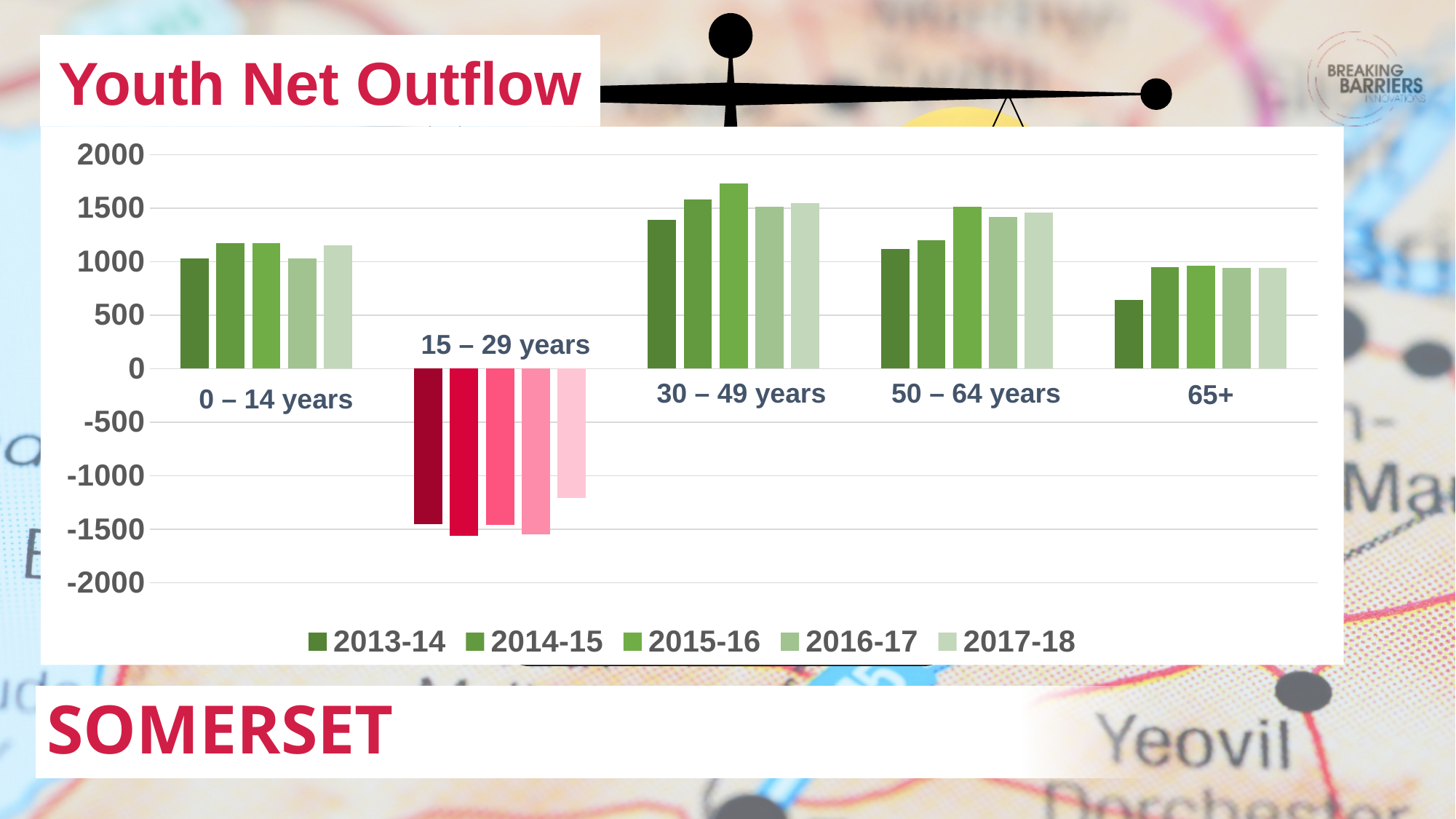
What kind of chart is shown on the slide? Bar chart Which age group has negative values for every year? 15 – 29 years Which is larger for 2013-14: the value for 30 – 49 years or the value for 50 – 64 years? 30 – 49 years Within the 30 – 49 years group, which year has the highest bar? 2015-16 Within the 65+ group, which year has the lowest bar? 2013-14 For the 30 – 49 years group, do the values rise or fall from 2013-14 to 2015-16? rise What is the title of the chart? Youth Net Outflow Is the 2017-18 value for 15 – 29 years greater or less than -1000? less How many series does the legend list? 5 Is the 2015-16 value for 30 – 49 years greater or less than 1500? greater Which age group has the highest value for 2015-16? 30 – 49 years How many age-group categories are shown on the x axis? 5